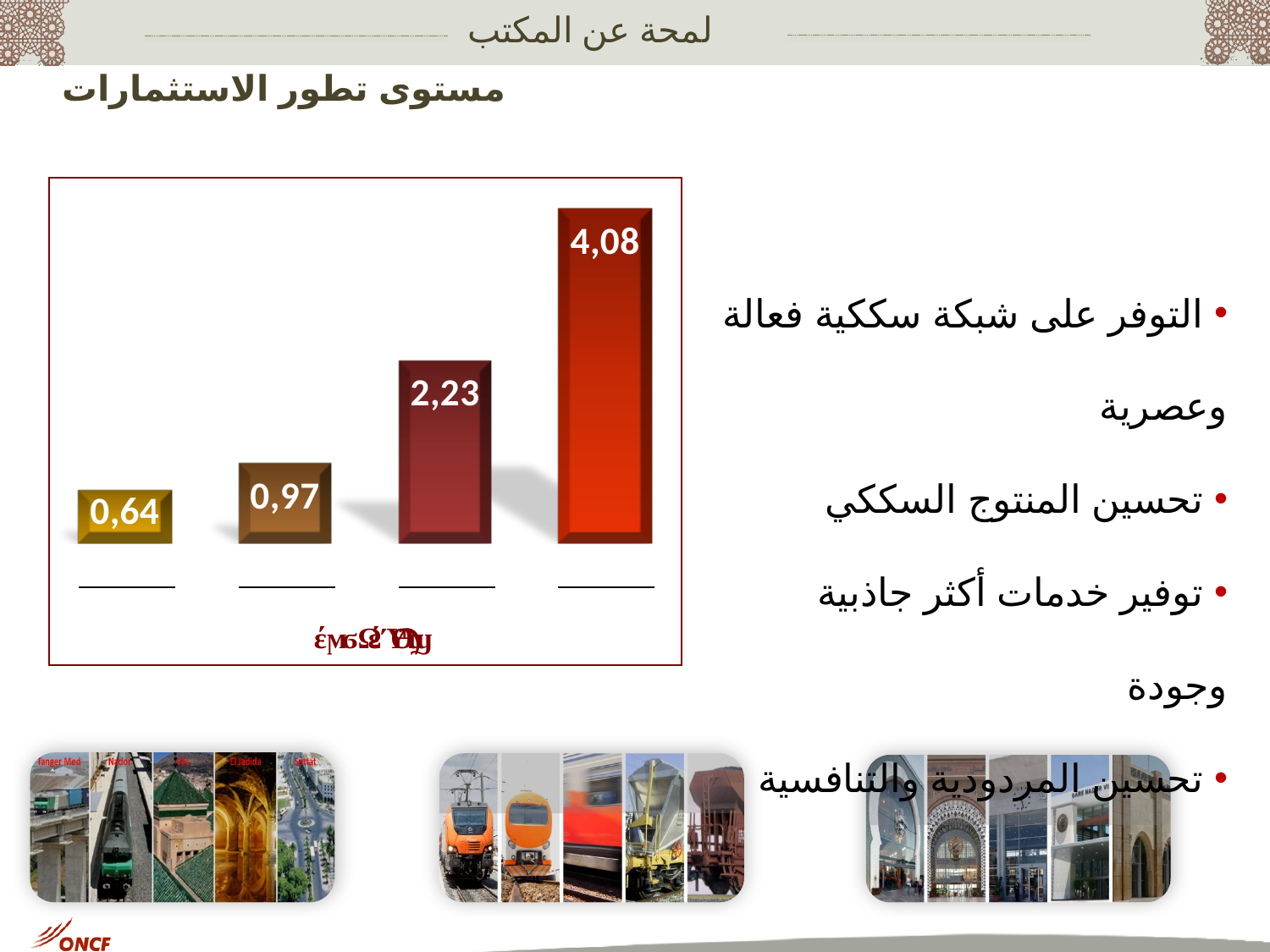
What is the value shown on the fourth (rightmost) bar of the chart? 4,08 Which bar has the lowest value? the first (leftmost) bar, 0,64 What type of chart is shown on the slide? bar chart What is the difference between the value of the rightmost bar and the value of the leftmost bar? 3,44 What is the value shown on the second bar from the left? 0,97 What colour is the tallest bar in the chart? red What is the value shown on the third bar from the left? 2,23 Which is larger: the value of the third bar or the value of the second bar? the third bar (2,23) Do the bar values rise or fall from left to right across the chart? rise What is the value shown on the first (leftmost) bar of the chart? 0,64 How many bars does the chart contain? 4 Which bar has the highest value? the fourth (rightmost) bar, 4,08